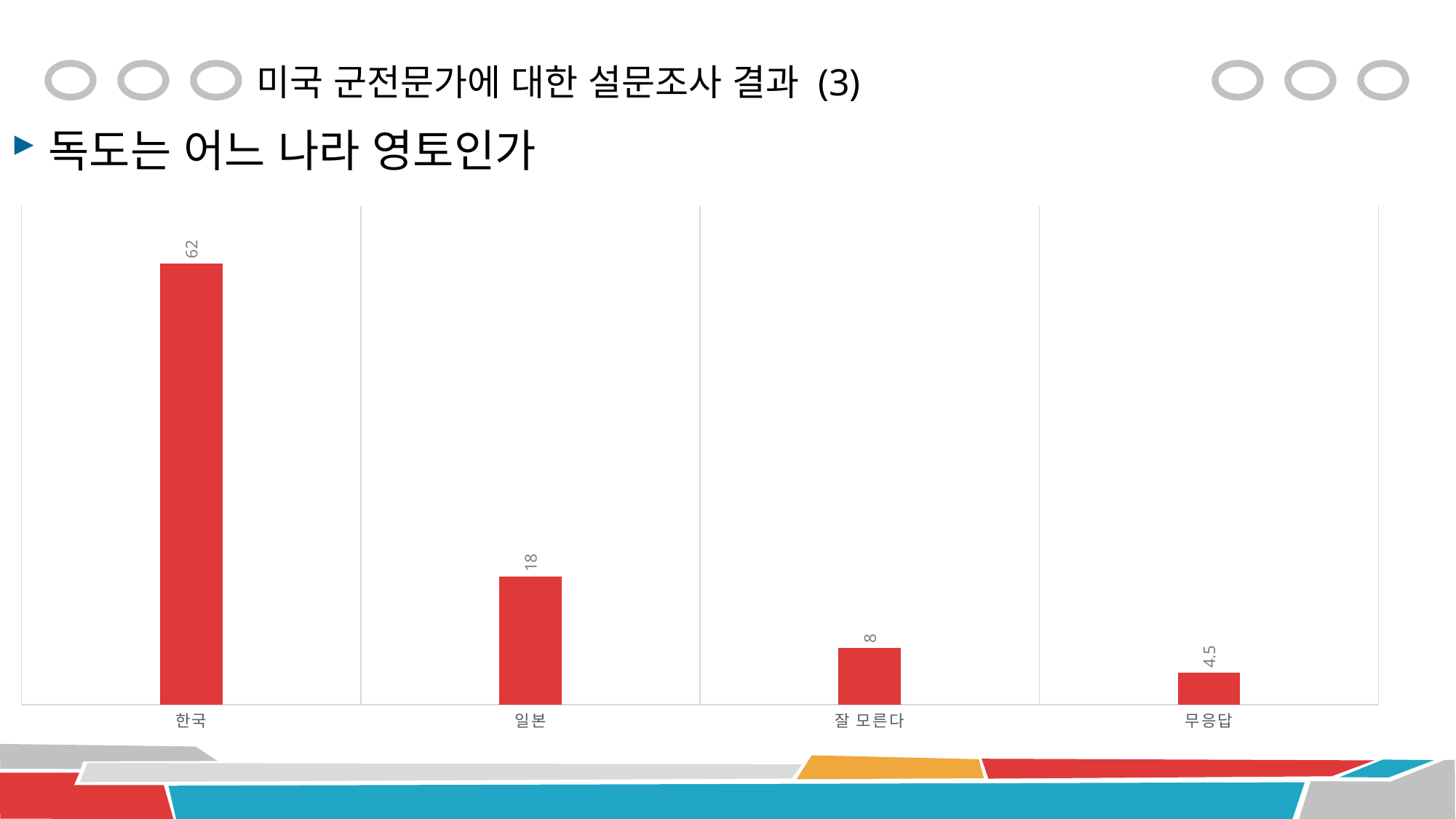
What is the difference between the values for 한국 and 일본? 44 What kind of chart is shown on the slide? bar chart What is the value for 일본? 18 What is the value for 잘 모른다? 8 What is the value for 한국? 62 Which is larger, the value for 일본 or the value for 잘 모른다? 일본 Do the values rise or fall from left to right across the categories? fall How many categories are shown in the chart? 4 What is the difference between the values for 잘 모른다 and 무응답? 3.5 What is the value for 무응답? 4.5 Which category has the highest value? 한국 Which category has the lowest value? 무응답